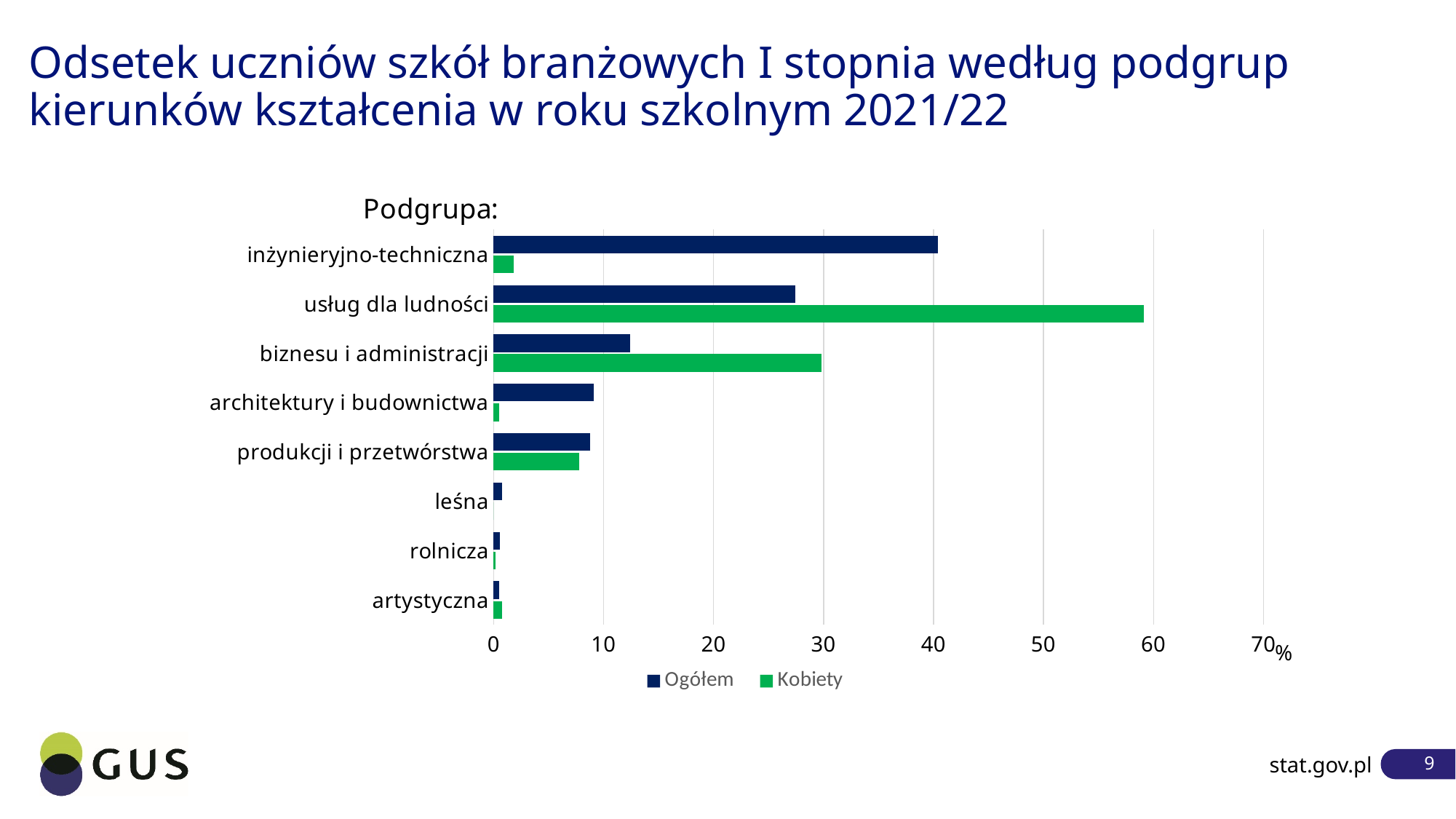
How many subgroups (categories) are shown on the chart? 8 Is the Ogółem value for usług dla ludności greater or less than 30? less What kind of chart is shown on the slide? bar chart Is the Kobiety value for inżynieryjno-techniczna greater or less than 10? less Is the Kobiety value for usług dla ludności greater or less than 50? greater How many series does the legend list? 2 For usług dla ludności, which series has the larger value, Ogółem or Kobiety? Kobiety For inżynieryjno-techniczna, which series has the larger value, Ogółem or Kobiety? Ogółem Which subgroup has the highest value for the Ogółem series? inżynieryjno-techniczna Which subgroup has the highest value for the Kobiety series? usług dla ludności Which subgroup has the lowest value for the Kobiety series? leśna